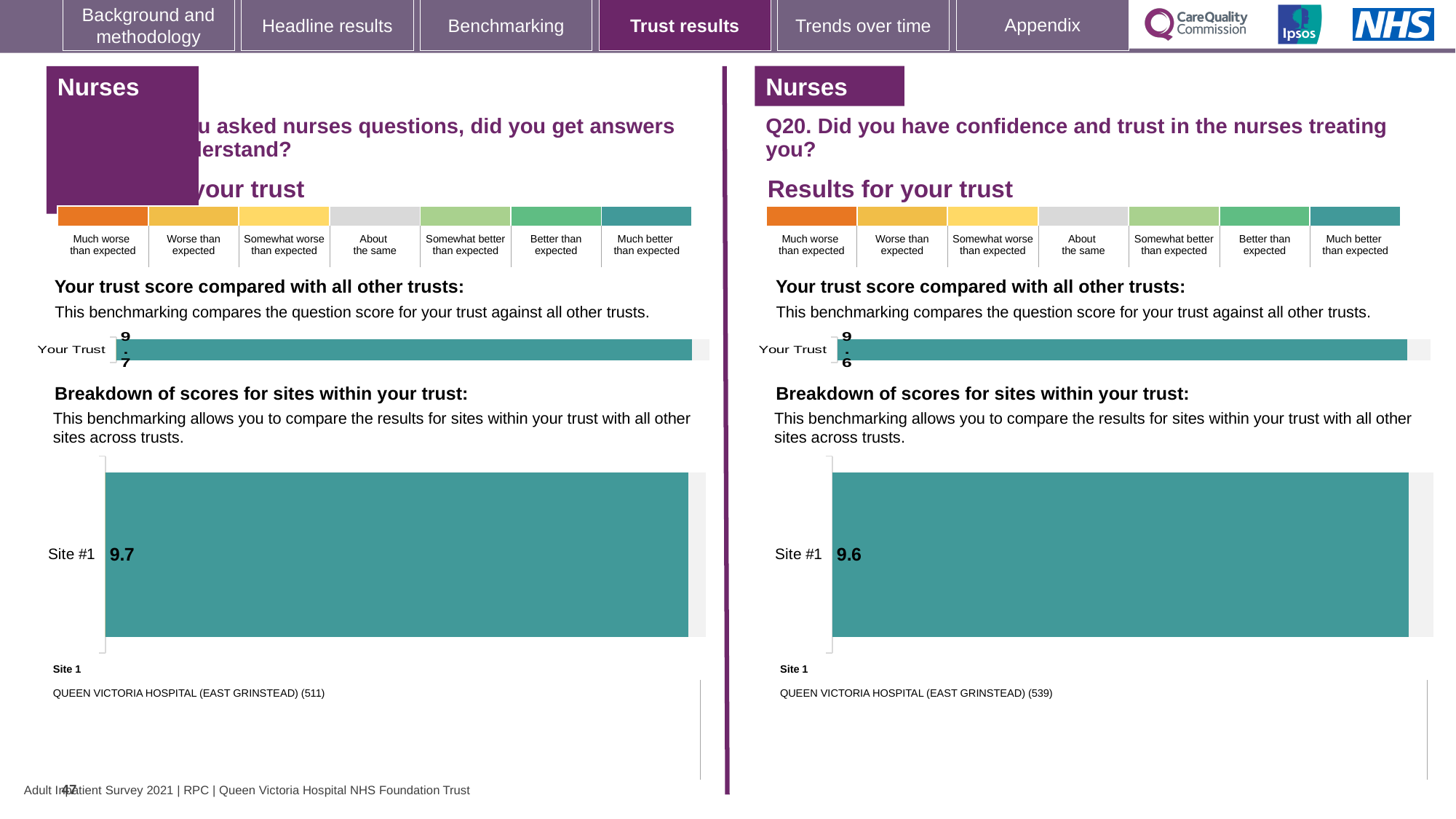
On the right-hand 'Breakdown of scores for sites within your trust' chart for Q20, what is the score for Site #1? 9.6 What type of chart is used for the 'Breakdown of scores for sites within your trust' on the left-hand side? Bar chart What colour are the bars in the 'Your Trust' and 'Site #1' charts on this slide? Teal What is the difference between the Your Trust score on the left-hand chart and the Your Trust score on the right-hand Q20 chart? 0.1 On the left-hand 'Breakdown of scores for sites within your trust' chart, what is the score for Site #1? 9.7 Which is larger: the Site #1 score on the left-hand breakdown chart or the Site #1 score on the right-hand breakdown chart for Q20? Left-hand (9.7) What type of chart is used to show the Your Trust score on the right-hand Q20 section? Bar chart On the right-hand chart for Q20 (confidence and trust in nurses), what is the score shown for Your Trust? 9.6 How many sites are shown in the left-hand 'Breakdown of scores for sites within your trust' chart? 1 Which site is listed as Site 1 beneath the right-hand Q20 breakdown chart? QUEEN VICTORIA HOSPITAL (EAST GRINSTEAD) (539) On the left-hand 'Your trust score compared with all other trusts' chart, what is the score shown for Your Trust? 9.7 How many sites are shown in the right-hand 'Breakdown of scores for sites within your trust' chart for Q20? 1